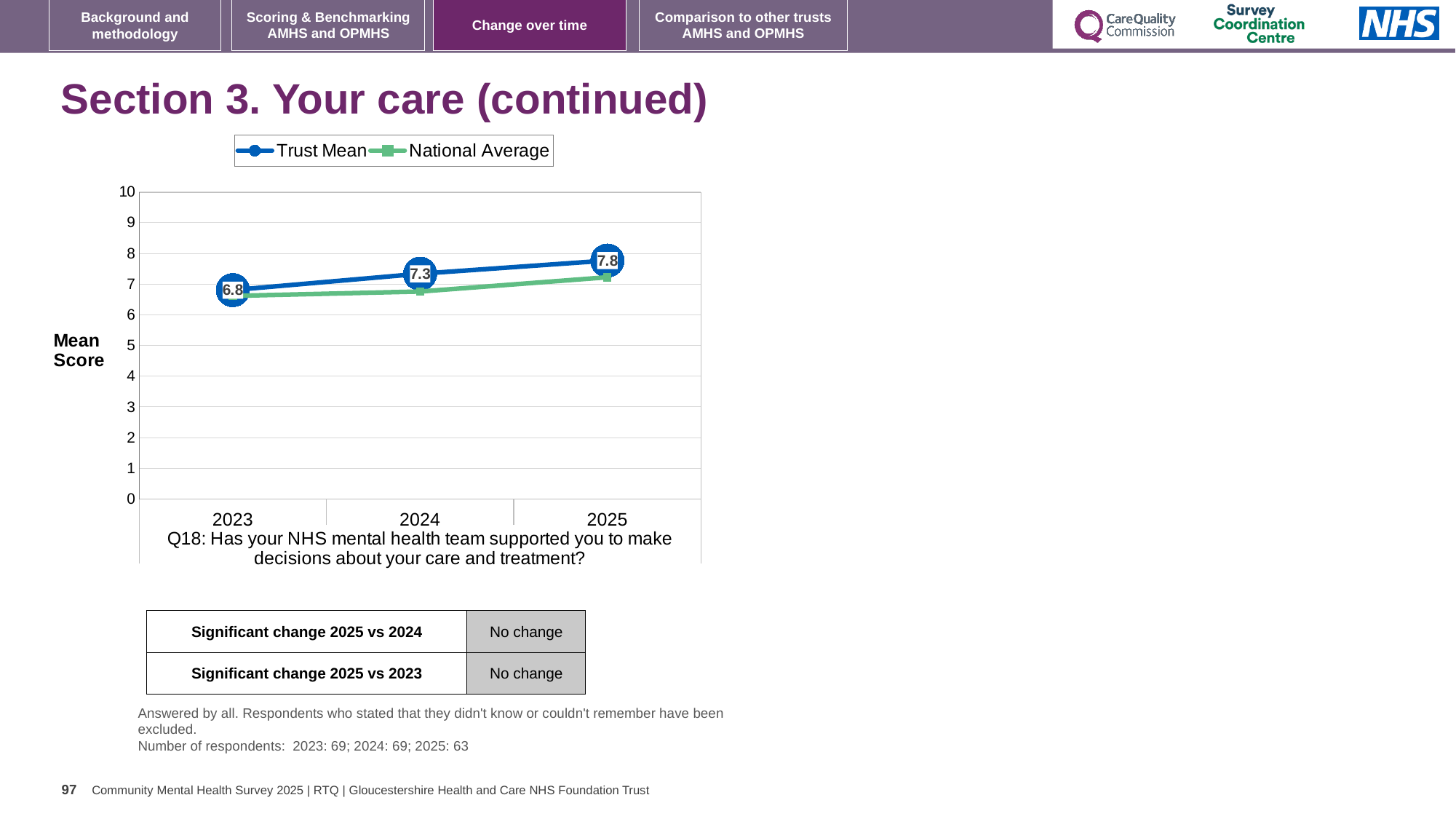
Is the National Average value for 2025 greater or less than 8? less Does the Trust Mean rise or fall from 2023 to 2025? rise How many series does the legend list? 2 Is the National Average value for 2023 greater or less than 7? less In which year is the Trust Mean lowest? 2023 Which is larger in 2024, the Trust Mean or the National Average? Trust Mean In which year is the Trust Mean highest? 2025 What is the difference between the Trust Mean in 2025 and in 2023? 1.0 How many years are plotted on the x axis? 3 What is the Trust Mean value for 2023? 6.8 What is the Trust Mean value for 2024? 7.3 What is the Trust Mean value for 2025? 7.8